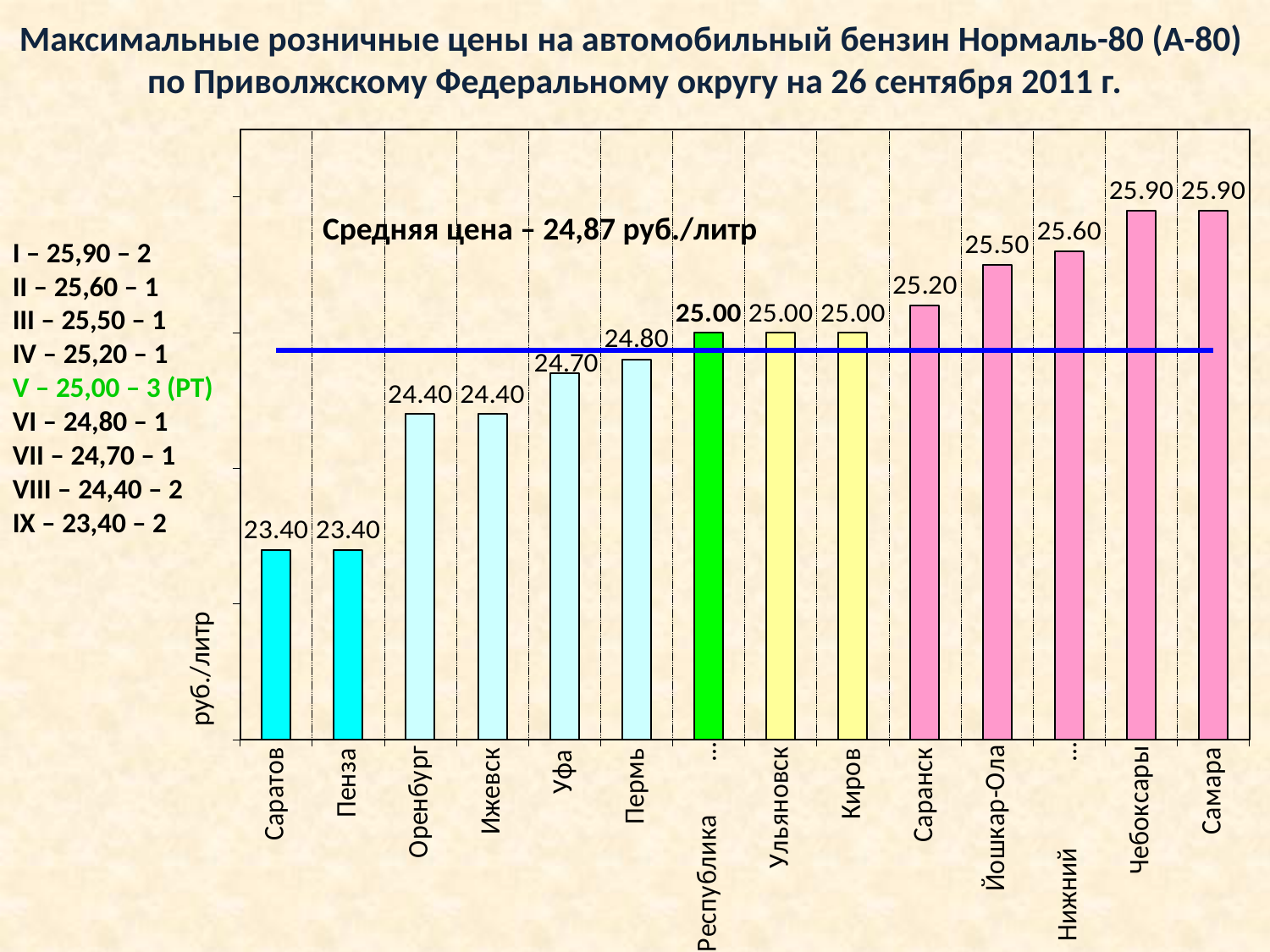
What is the difference between the values for Нижний and Пермь? 0.80 What is the difference between the values for Самара and Саратов? 2.50 Which category has the lowest value, Пенза or Оренбург? Пенза What is the value for Саратов? 23.40 What is the value for Йошкар-Ола? 25.50 Which is larger, the value for Киров or the value for Ижевск? Киров What kind of chart is shown on the slide? Bar chart What is the value for Ульяновск? 25.00 What average price is stated on the chart? 24,87 руб./литр What is the value for Уфа? 24.70 What is the value for Саранск? 25.20 How many bars are plotted in the chart? 14